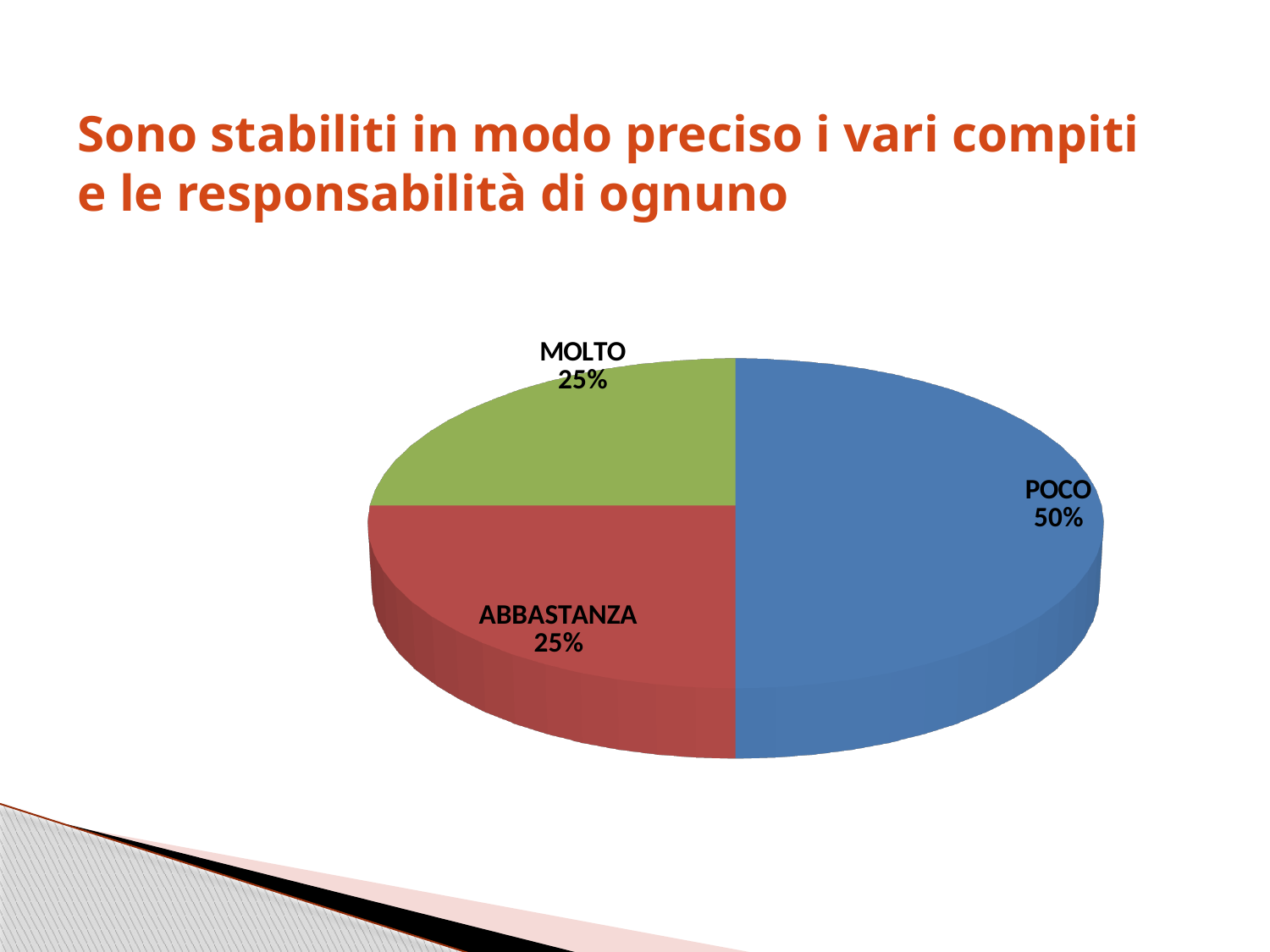
How many slices does the pie chart have? 3 What share of the pie does ABBASTANZA represent? 25% Which category has the largest slice of the pie? POCO What share of the pie does POCO represent? 50% What is the title of the slide above the chart? Sono stabiliti in modo preciso i vari compiti e le responsabilità di ognuno What colour is the POCO slice? Blue Which is larger, the slice for POCO or the slice for ABBASTANZA? POCO What is the difference in percentage points between POCO and MOLTO? 25 What kind of chart is shown on the slide? Pie chart What is the combined share of MOLTO and ABBASTANZA? 50% What share of the pie does MOLTO represent? 25%